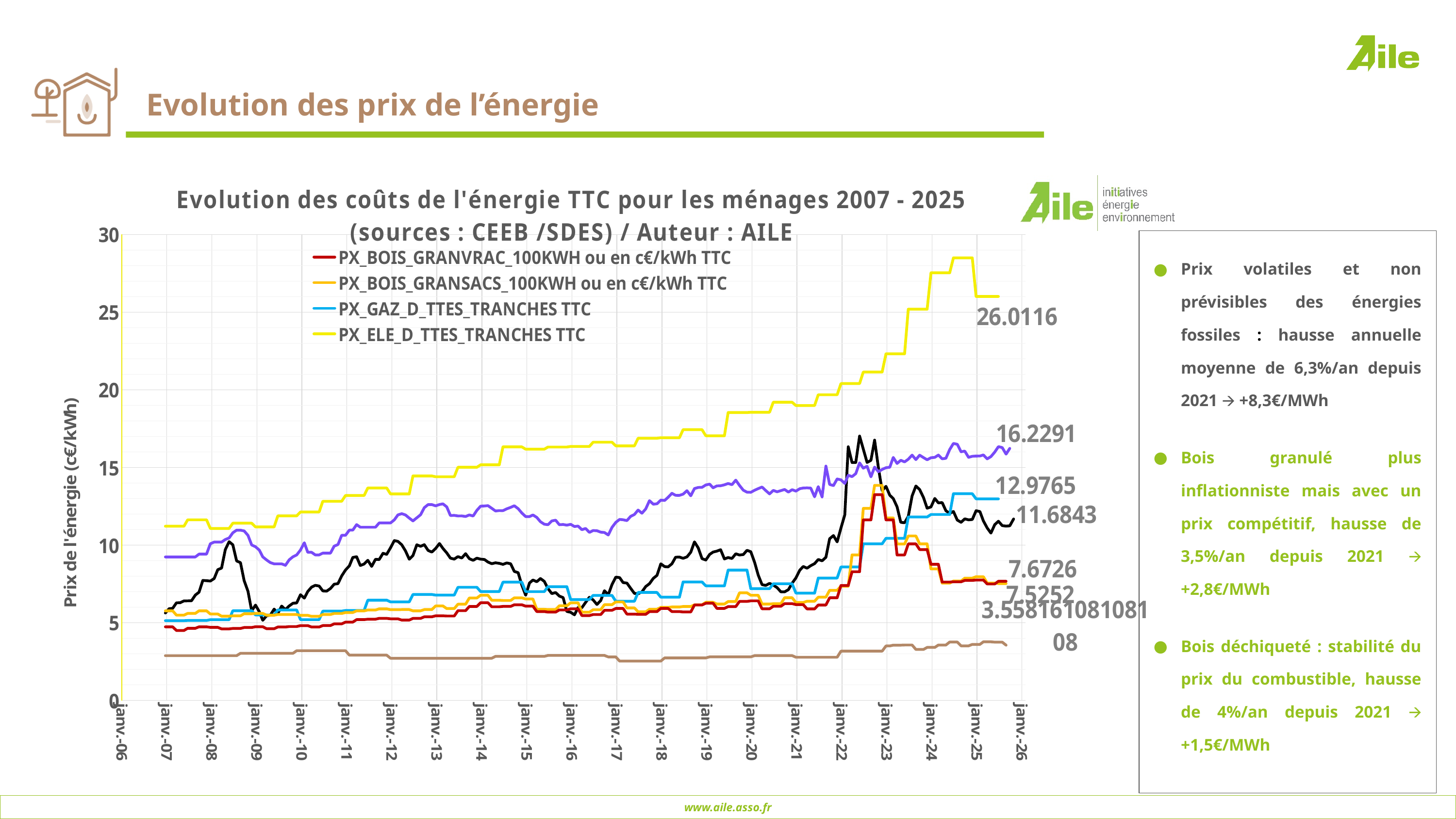
What is the final labelled value of the PX_ELE_D_TTES_TRANCHES TTC series? 26.0116 Is the value of PX_GAZ_D_TTES_TRANCHES TTC in janv.-07 greater or less than 10? less At the end of the chart, which is larger: the PX_GAZ_D_TTES_TRANCHES TTC value or the PX_ELE_D_TTES_TRANCHES TTC value? PX_ELE_D_TTES_TRANCHES TTC Is the peak value of the PX_ELE_D_TTES_TRANCHES TTC series greater or less than 25? greater What kind of chart is shown on the slide? line chart What is the label of the chart's vertical axis? Prix de l'énergie (c€/kWh) How many series does the chart legend list? 4 Is the value of PX_ELE_D_TTES_TRANCHES TTC in janv.-07 greater or less than 10? greater Which legend series has the highest value at the end of the chart? PX_ELE_D_TTES_TRANCHES TTC What is the final labelled value of the PX_GAZ_D_TTES_TRANCHES TTC series? 12.9765 What is the difference between the final labelled values of PX_ELE_D_TTES_TRANCHES TTC (26.0116) and PX_GAZ_D_TTES_TRANCHES TTC (12.9765)? 13.0351 Does the PX_ELE_D_TTES_TRANCHES TTC series generally rise or fall from 2007 to 2025? rise